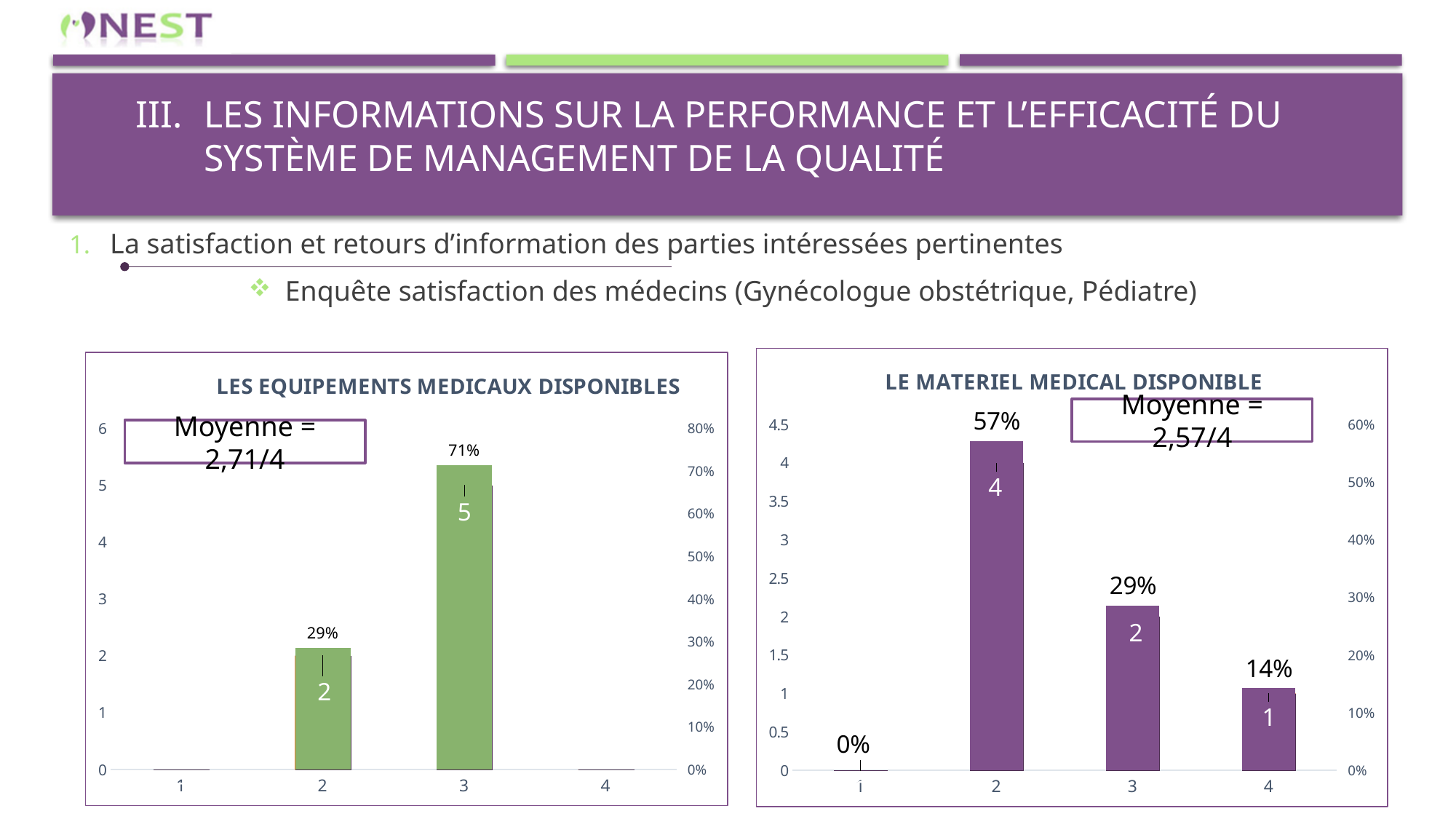
In the chart titled "LES EQUIPEMENTS MEDICAUX DISPONIBLES", what percentage is shown for category 2? 29% In the chart titled "LE MATERIEL MEDICAL DISPONIBLE", what percentage is shown for category 1? 0% In the chart titled "LES EQUIPEMENTS MEDICAUX DISPONIBLES", what average (Moyenne) is shown in the text box? 2,71/4 In the chart titled "LES EQUIPEMENTS MEDICAUX DISPONIBLES", what is the count value shown for category 3? 5 In the chart titled "LE MATERIEL MEDICAL DISPONIBLE", what percentage is shown for category 4? 14% In the chart titled "LES EQUIPEMENTS MEDICAUX DISPONIBLES", what is the difference between the count values for category 3 and category 2? 3 In the chart titled "LES EQUIPEMENTS MEDICAUX DISPONIBLES", which category has the highest value? 3 In the chart titled "LE MATERIEL MEDICAL DISPONIBLE", which category has the highest value? 2 In the chart titled "LE MATERIEL MEDICAL DISPONIBLE", what is the difference between the percentages for category 2 and category 3? 28% In the chart titled "LE MATERIEL MEDICAL DISPONIBLE", which is larger, the value for category 3 or category 4? category 3 What kind of chart is the chart titled "LE MATERIEL MEDICAL DISPONIBLE"? bar chart In the chart titled "LE MATERIEL MEDICAL DISPONIBLE", what is the count value shown for category 2? 4